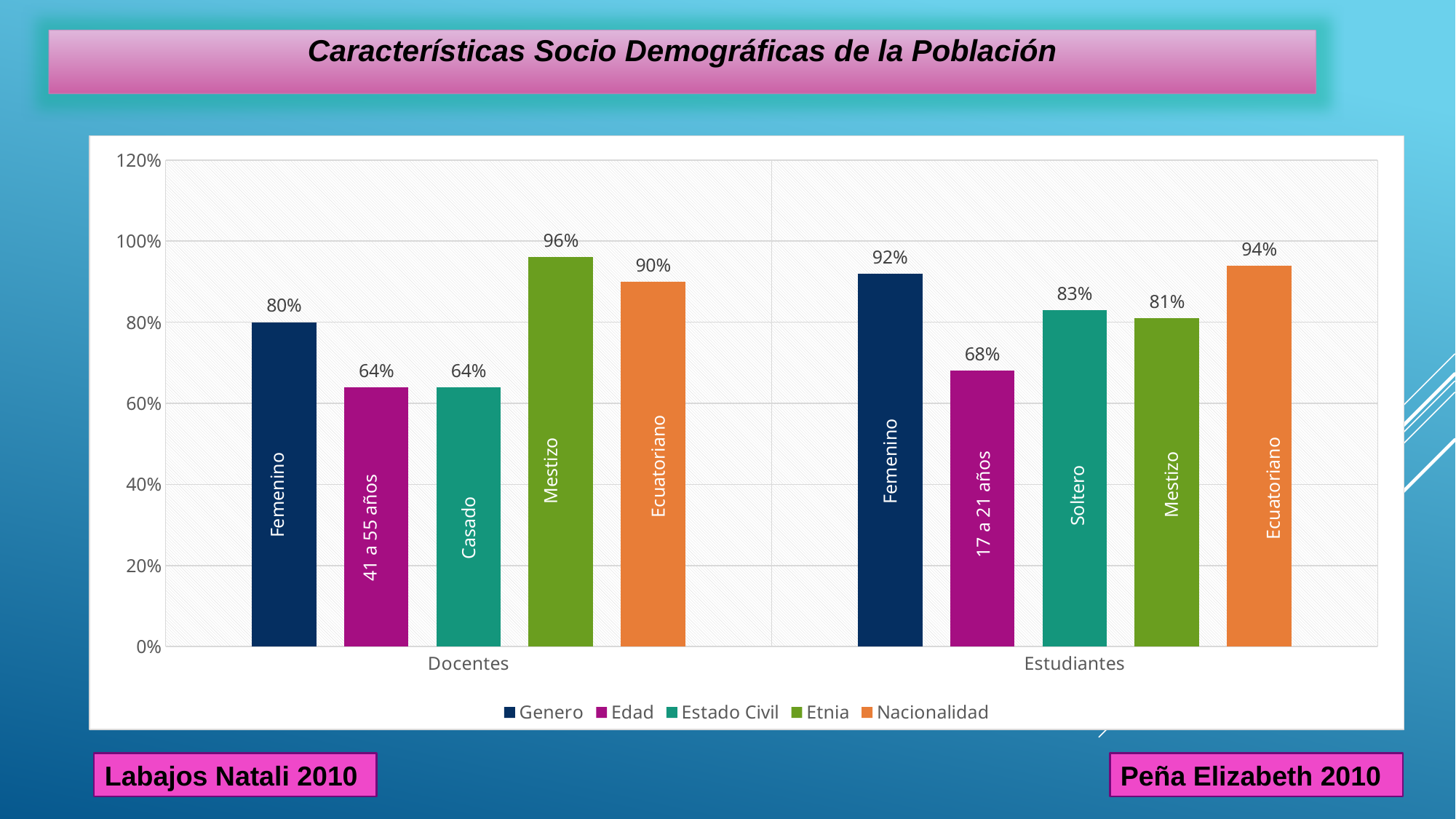
What is the value of the Genero bar for Docentes? 80% How many series does the legend list? 5 How many categories are shown on the x axis? 2 Which series has the lowest value in the Estudiantes group? Edad What is the value of the Nacionalidad bar for Estudiantes? 94% What label is written inside the Estado Civil bar for Estudiantes? Soltero Is the Estado Civil value for Docentes greater or less than 80%? less What is the difference between the Etnia value for Docentes and the Etnia value for Estudiantes? 15% What is the value of the Edad bar for Estudiantes? 68% Which series has the highest value in the Docentes group? Etnia What kind of chart is shown on the slide? bar chart Which is larger: the Genero value for Docentes or the Genero value for Estudiantes? Estudiantes